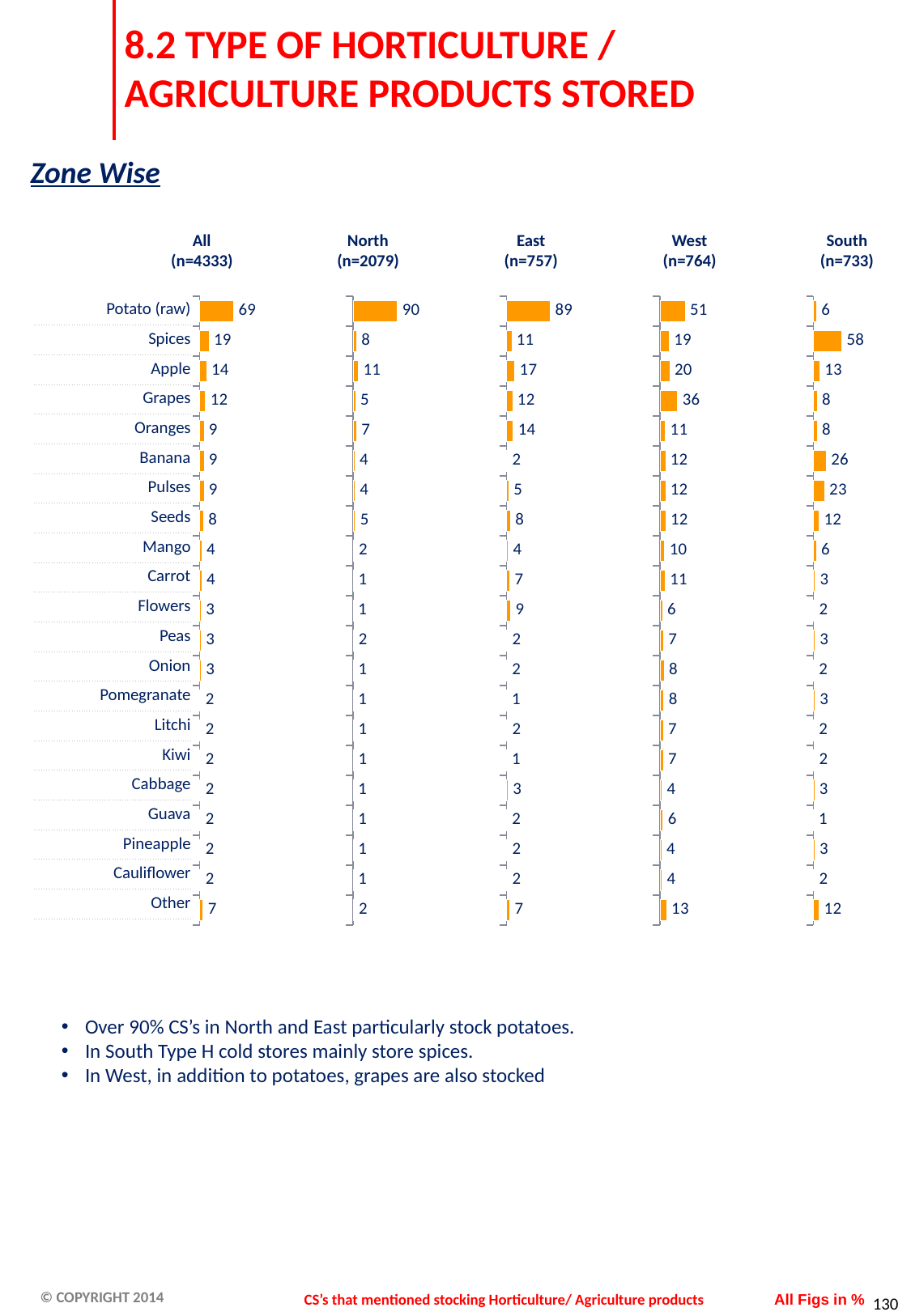
In the West (n=764) chart, what is the value for Other? 13 In the South (n=733) chart, which category has the highest value? Spices In the South (n=733) chart, which is larger, the value for Banana or the value for Pulses? Banana How many product categories are listed in the All (n=4333) chart? 21 In the West (n=764) chart, what is the value for Grapes? 36 What is the sample size shown in the heading of the West chart? n=764 In the East (n=757) chart, what is the value for Flowers? 9 In the North (n=2079) chart, what is the value for Spices? 8 In the East (n=757) chart, what is the difference between the values for Potato (raw) and Apple? 72 In the North (n=2079) chart, which category has the highest value? Potato (raw) In the All (n=4333) chart, what is the value for Potato (raw)? 69 What kind of chart is the North (n=2079) chart? Bar chart